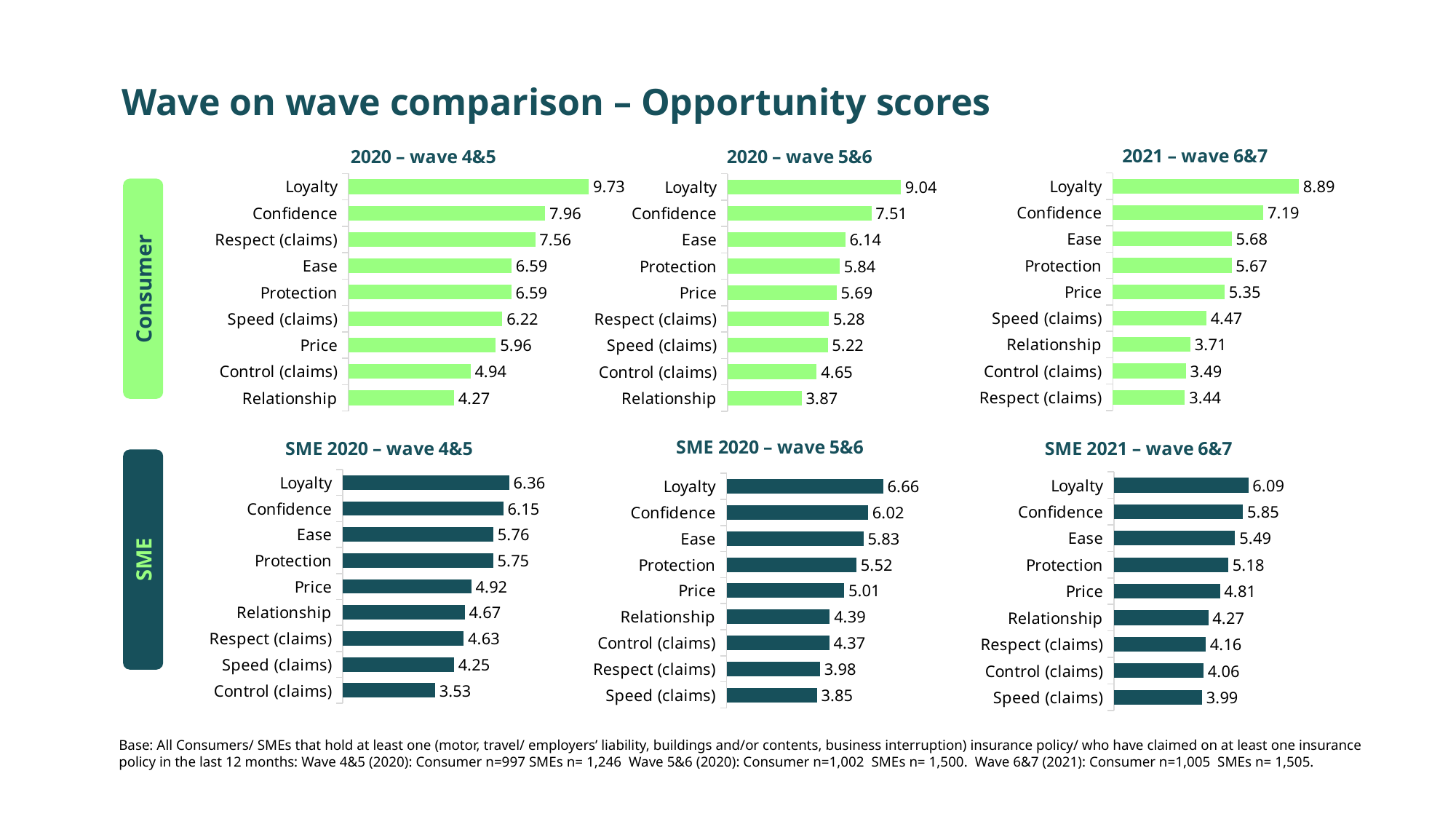
In the SME 2020 – wave 4&5 chart, what is the difference between Loyalty and Control (claims)? 2.83 In the SME 2021 – wave 6&7 chart, which category has the lowest value? Speed (claims) In the Consumer 2021 – wave 6&7 chart, what is the difference between Loyalty and Confidence? 1.70 In the Consumer 2021 – wave 6&7 chart, what is the value for Respect (claims)? 3.44 In the Consumer 2020 – wave 5&6 chart, which category has the highest value? Loyalty In the SME 2020 – wave 5&6 chart, what is the value for Price? 5.01 In the Consumer 2020 – wave 5&6 chart, which is larger, Ease or Price? Ease What colour are the bars in the SME charts? Dark teal What type of chart is the Consumer 2020 – wave 4&5 chart? Bar chart In the SME 2020 – wave 5&6 chart, what is the value for Relationship? 4.39 How many categories are shown in the SME 2021 – wave 6&7 chart? 9 In the Consumer 2020 – wave 4&5 chart, what is the value for Loyalty? 9.73